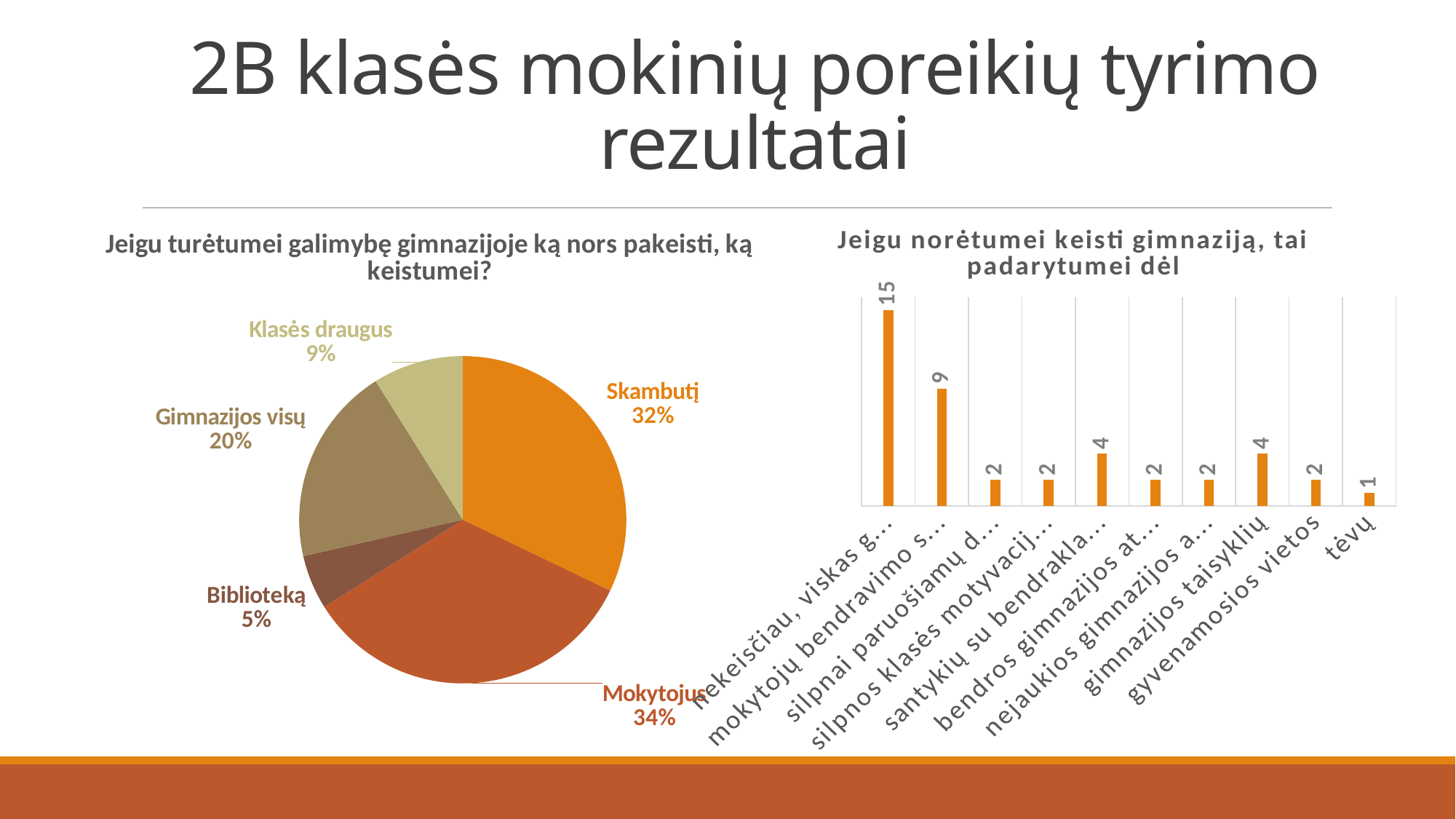
In the pie chart on the left, what percentage is shown for Biblioteką? 5% How many bars are in the bar chart on the right? 10 In the pie chart on the left, which category has the largest share? Mokytojus In the pie chart on the left, which is larger: Skambutį or Gimnazijos visų? Skambutį In the bar chart on the right, what is the value for gimnazijos taisyklių? 4 In the pie chart on the left, what is the difference in percentage points between Gimnazijos visų and Klasės draugus? 11 In the pie chart on the left, what percentage is shown for Mokytojus? 34% In the bar chart on the right, what is the highest value shown on any bar? 15 In the pie chart on the left, which category has the smallest share? Biblioteką In the bar chart on the right, what is the value for tėvų? 1 How many slices does the pie chart on the left have? 5 What type of chart is the chart on the right titled 'Jeigu norėtumei keisti gimnaziją, tai padarytumei dėl'? bar chart